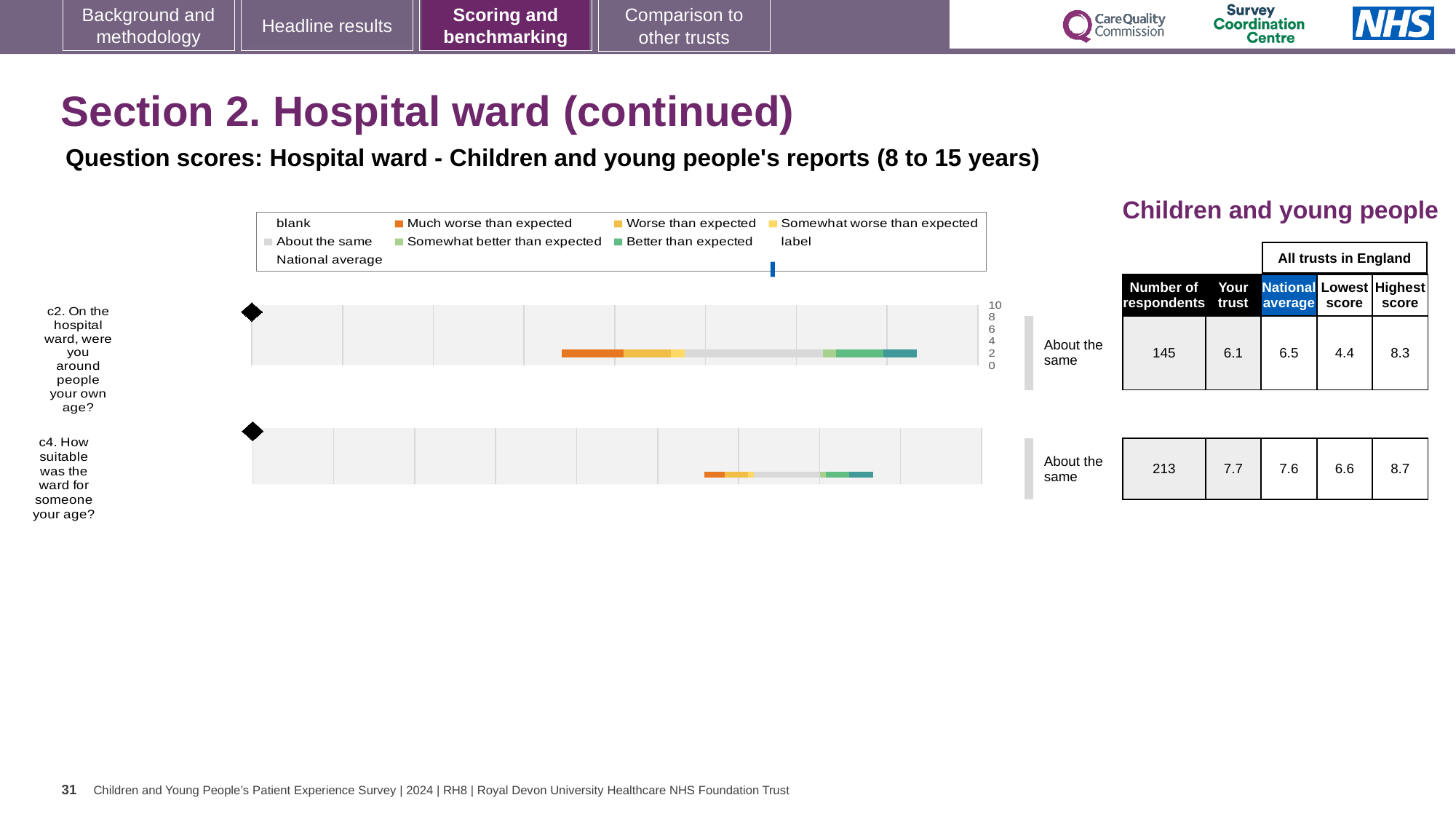
For c4, what is the difference between the highest score and the lowest score across all trusts in England? 2.1 What kind of chart is used to show the question scores for c2 and c4? bar chart What benchmark category is shown for question c2? About the same Which question has the higher 'Your trust' score, c2 or c4? c4 What is the national average score for c4 (How suitable was the ward for someone your age?)? 7.6 What is the highest score among all trusts in England for c4? 8.7 For c2, how much higher is the national average than the 'Your trust' score? 0.4 What colour does the legend use for 'Much worse than expected'? Orange How many respondents answered question c2? 145 For c2, which is larger: the 'Your trust' score or the national average? National average What is the 'Your trust' score for c2 (On the hospital ward, were you around people your own age?)? 6.1 How many questions are plotted on the slide? 2